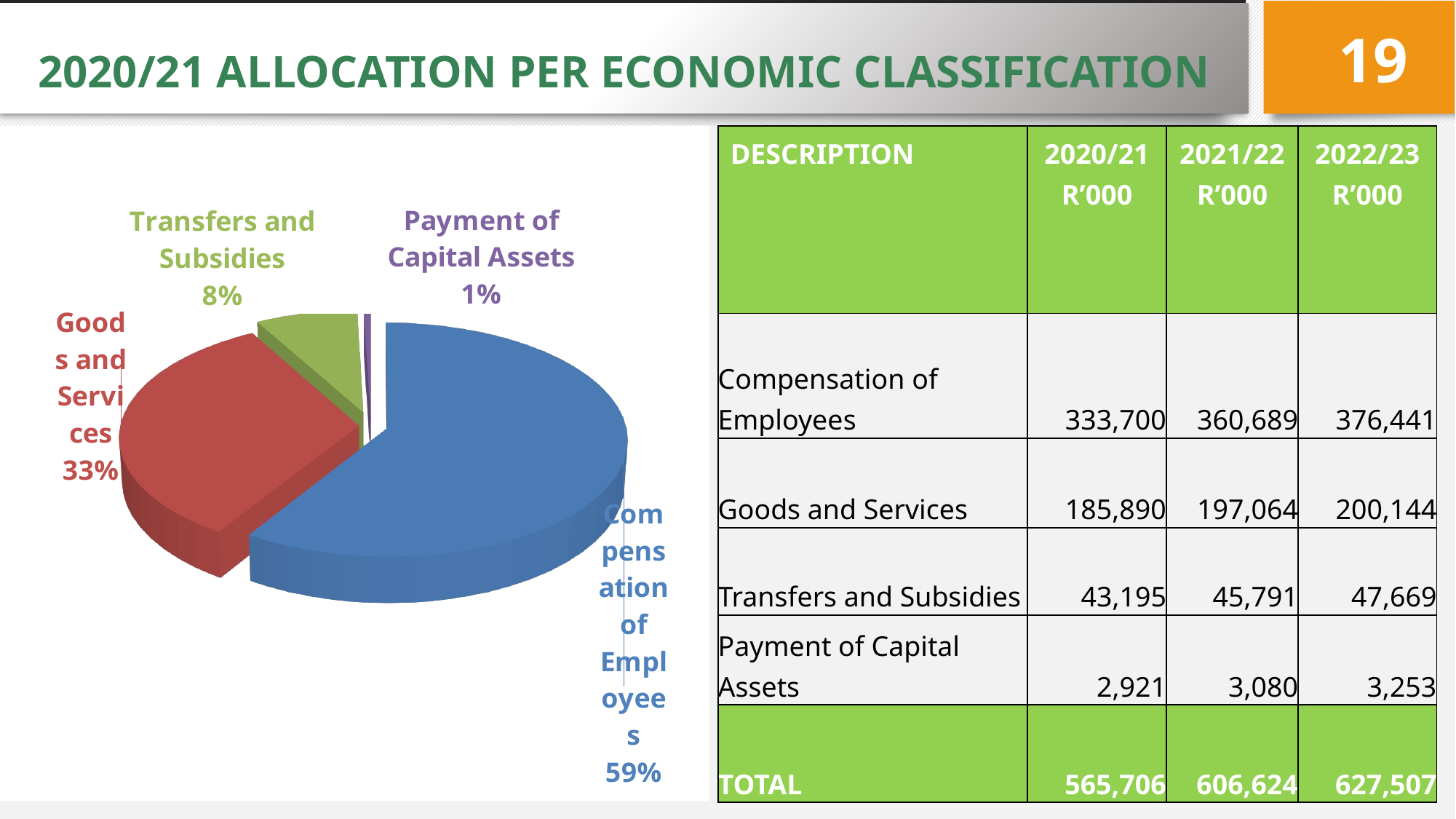
What share of the pie does Compensation of Employees represent? 59% What share of the pie does Payment of Capital Assets represent? 1% What kind of chart is shown on the slide? Pie chart Which slice is larger: Transfers and Subsidies or Goods and Services? Goods and Services What share of the pie does Transfers and Subsidies represent? 8% Which category has the largest slice of the pie? Compensation of Employees How many slices does the pie chart have? 4 Which category has the smallest slice of the pie? Payment of Capital Assets What is the difference in percentage points between the Compensation of Employees slice and the Goods and Services slice? 26% What colour is the Compensation of Employees slice of the pie? Blue What colour is the Goods and Services slice of the pie? Red